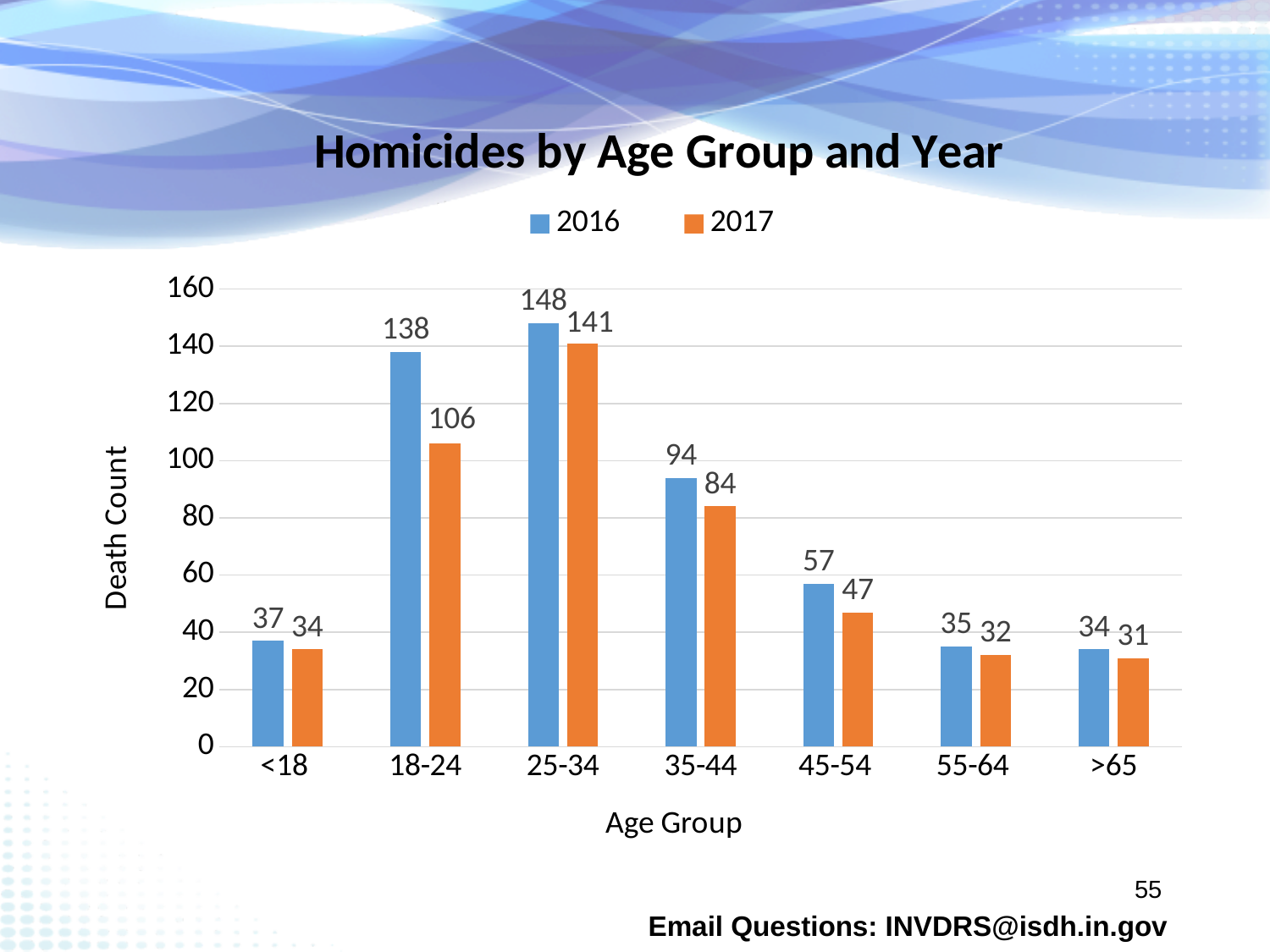
What is the 2016 death count for the 18-24 age group? 138 What is the label of the y axis? Death Count What is the 2017 death count for the 25-34 age group? 141 What is the difference between the 2016 and 2017 death counts for the 18-24 age group? 32 Which age group has the highest 2016 death count? 25-34 How many series does the legend list? 2 What is the title of the chart? Homicides by Age Group and Year How many age groups are shown on the x axis? 7 Which age group has the lowest 2017 death count? >65 Which is larger for the 45-54 age group, the 2016 or the 2017 death count? 2016 What is the 2017 death count for the 35-44 age group? 84 What kind of chart is shown on the slide? Bar chart